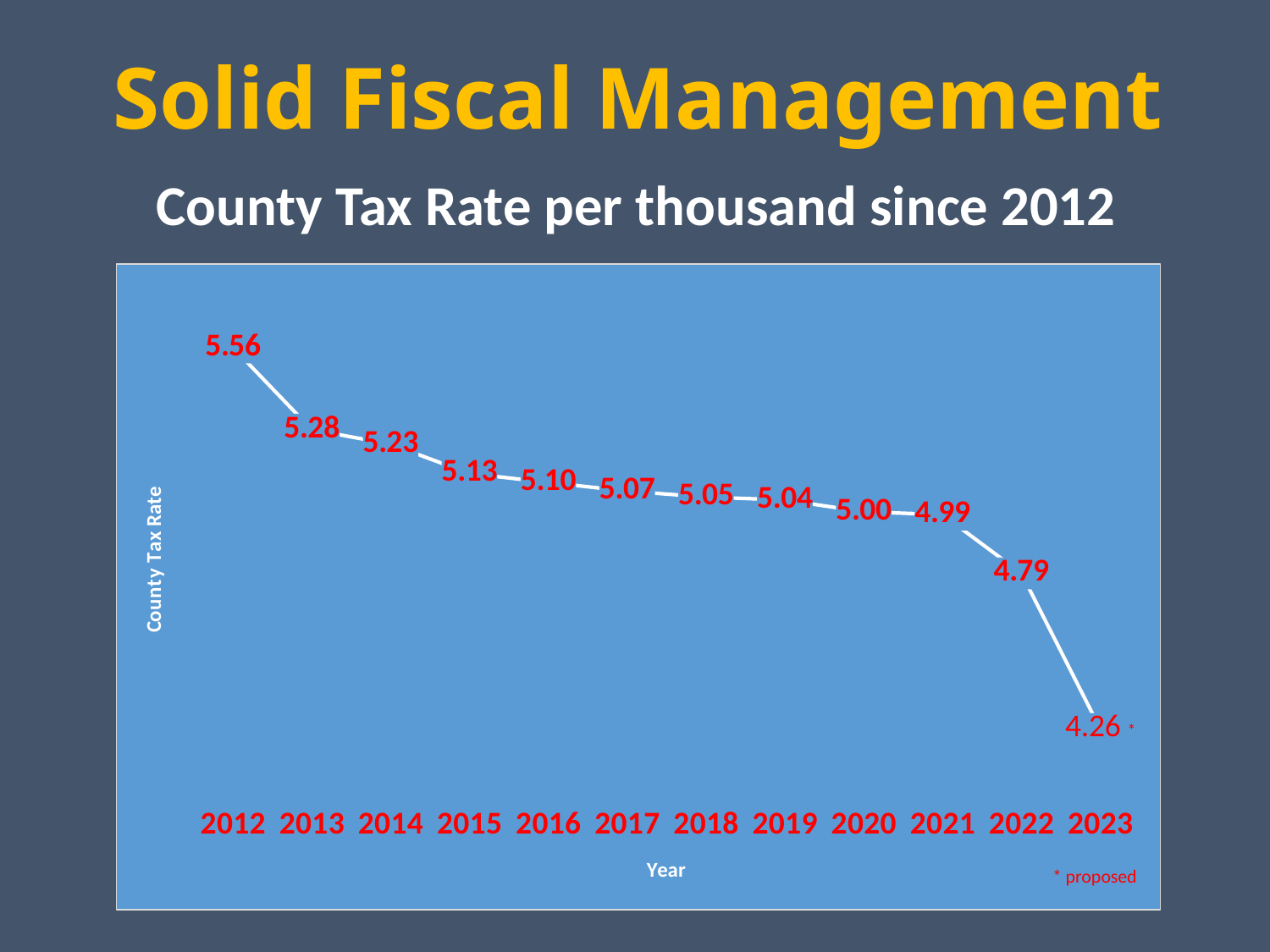
What kind of chart is shown on the slide? Line chart What was the County Tax Rate in 2018? 5.05 What is the proposed County Tax Rate for 2023? 4.26 What was the County Tax Rate in 2012? 5.56 Which year had a higher County Tax Rate, 2014 or 2020? 2014 Which year has the highest County Tax Rate? 2012 What is the difference between the County Tax Rate in 2012 and the proposed rate for 2023? 1.30 Does the County Tax Rate rise or fall from 2012 to 2023? Fall What was the County Tax Rate in 2022? 4.79 Which year has the lowest County Tax Rate? 2023 How many years are plotted on the chart? 12 By how much did the County Tax Rate fall from 2021 to 2022? 0.20